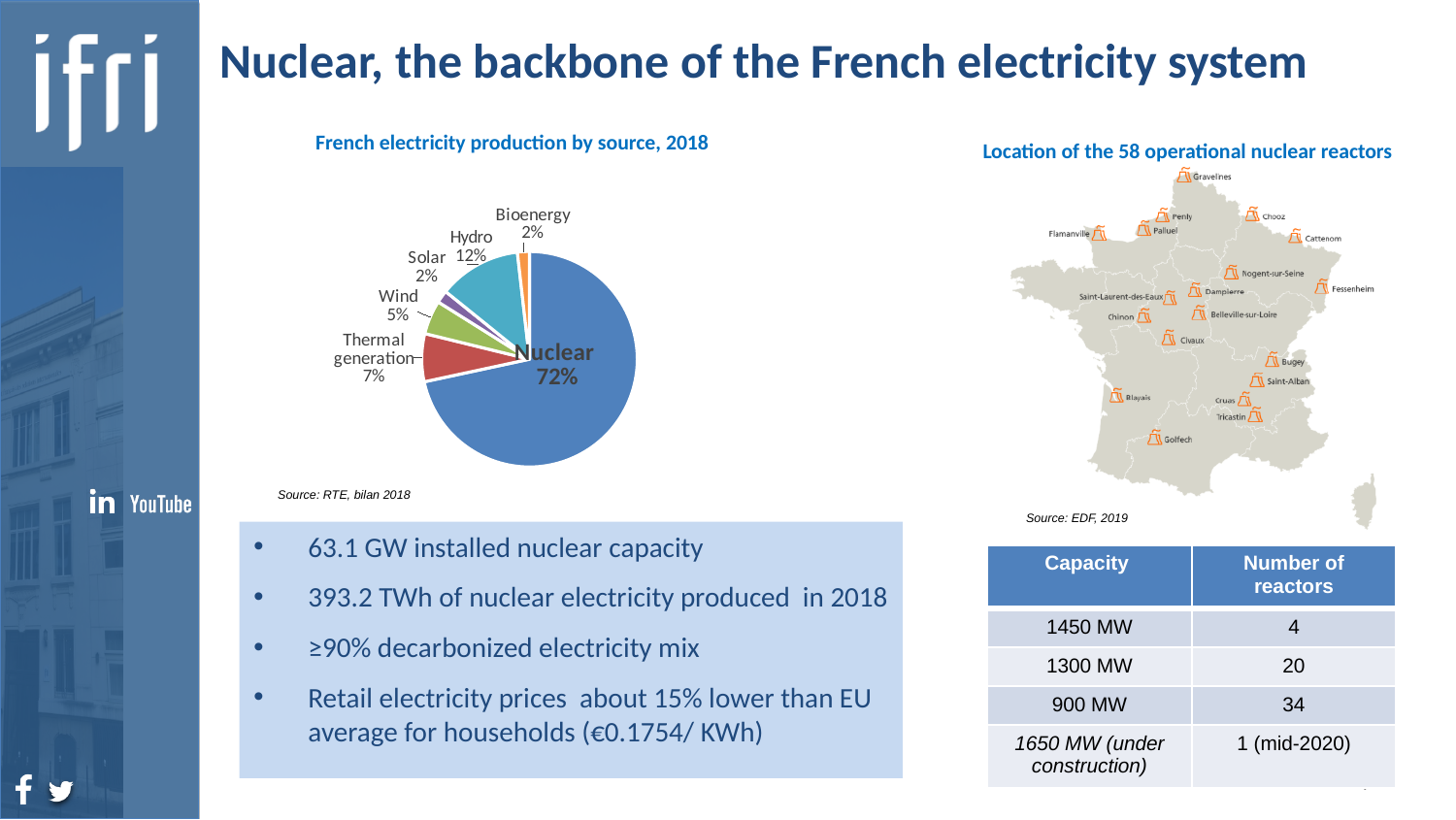
What is the title of the chart on the left of the slide? French electricity production by source, 2018 Which source has the largest slice in the pie chart? Nuclear What type of chart is used to show French electricity production by source? Pie chart In the pie chart, what percentage of French electricity production in 2018 came from Hydro? 12% In the pie chart, which has a larger share: Hydro or Thermal generation? Hydro What colour is the Nuclear slice in the pie chart? Blue In the pie chart 'French electricity production by source, 2018', what share does Nuclear have? 72% In the pie chart, what is the share of Bioenergy? 2% In the pie chart, how many percentage points larger is the Nuclear share than the Hydro share? 60 percentage points How many sources (slices) are shown in the pie chart? 6 In the pie chart, what is the share of Thermal generation? 7% In the pie chart, what is the share of Wind? 5%